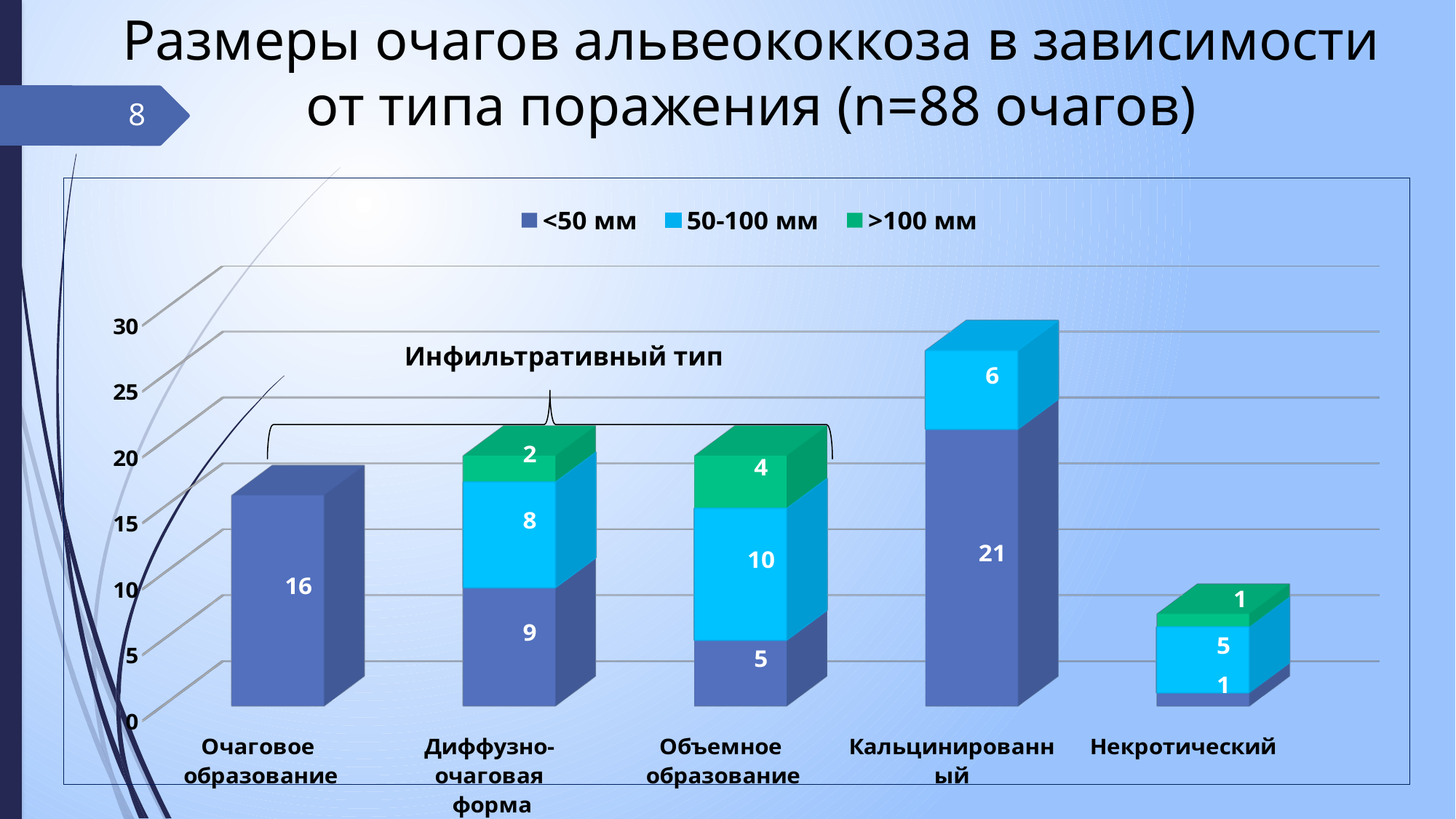
What is the difference between the <50 мм values for Кальцинированный and Очаговое образование? 5 Which category has the highest total stacked bar? Кальцинированный Which is larger: the 50-100 мм value for Диффузно-очаговая форма or for Кальцинированный? Диффузно-очаговая форма What is the value of the >100 мм series for Диффузно-очаговая форма? 2 What is the total of the stacked bar for Некротический? 7 What is the value of the 50-100 мм series for Объемное образование? 10 What is the value of the <50 мм series for Кальцинированный? 21 How many series does the legend list? 3 Which category has the lowest total stacked bar? Некротический How many categories are shown on the x axis? 5 What kind of chart is shown on the slide? Stacked bar chart What is the total of the stacked bar for Кальцинированный? 27